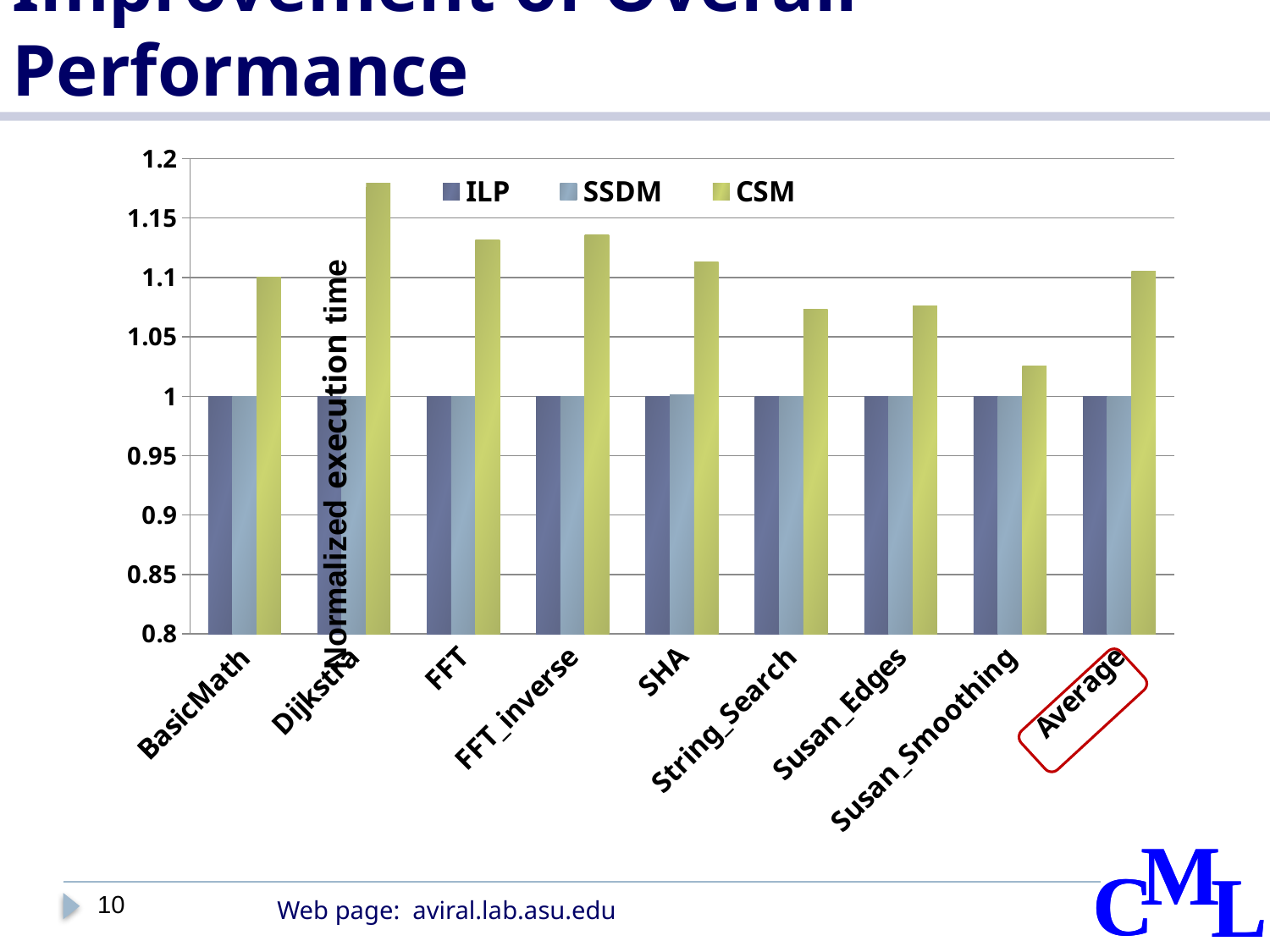
How many series does the legend list? 3 How many categories are shown along the x axis? 9 Which category has the lowest CSM value? Susan_Smoothing Which category has the highest CSM value? Dijkstra What is the label of the y axis? Normalized execution time Is the CSM value for Dijkstra greater or less than 1.15? greater What kind of chart is shown on the slide? bar chart Is the CSM value for Susan_Smoothing greater or less than 1.05? less Is the CSM value for BasicMath greater or less than 1.05? greater Which category on the x axis is circled in red? Average What is the ILP value for BasicMath? 1 Which is larger, the CSM value for FFT or the CSM value for SHA? FFT